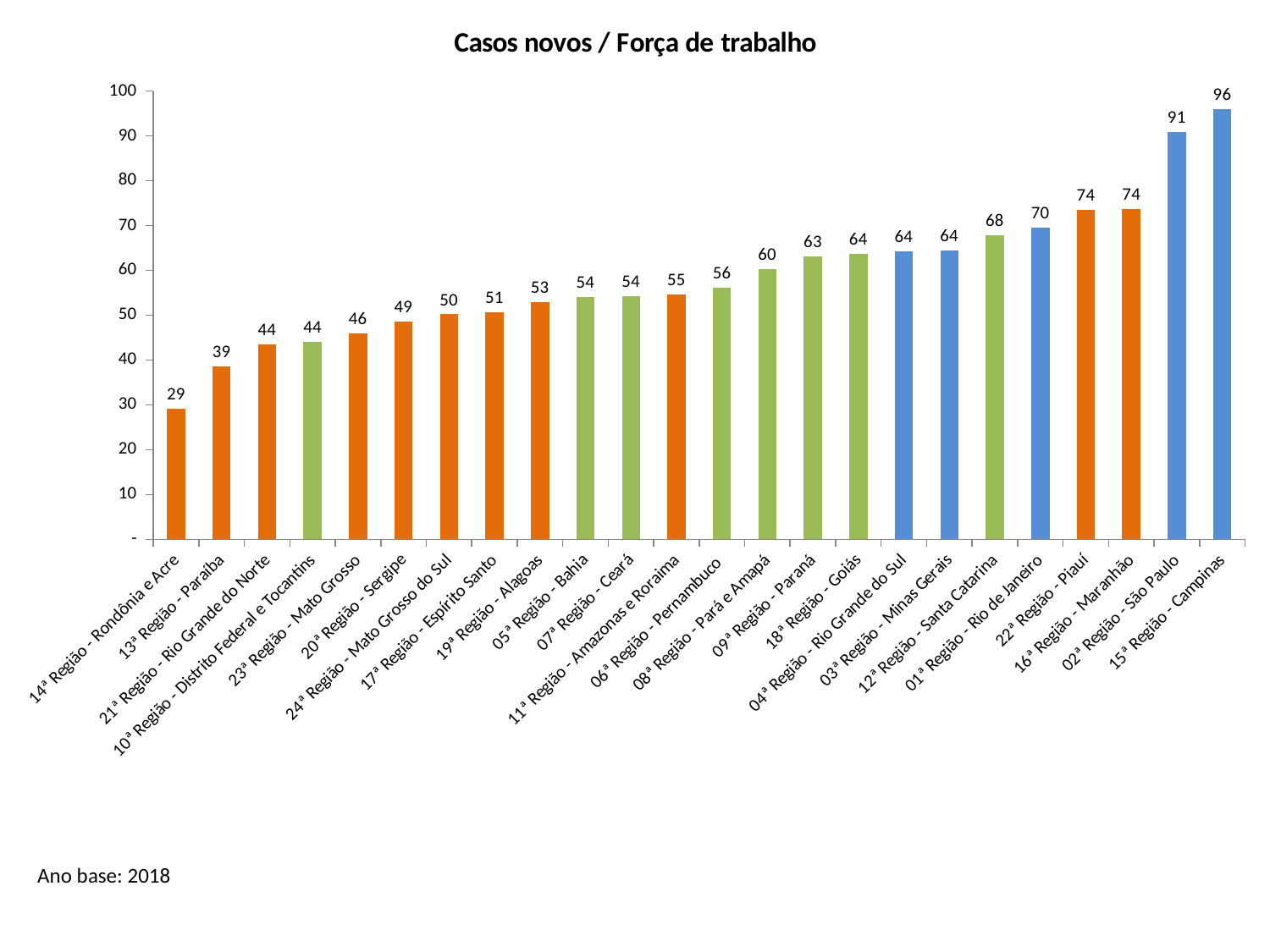
How many bars are plotted in the chart? 24 What is the value for 14ª Região - Rondônia e Acre? 29 What is the difference between the values for 15ª Região - Campinas and 02ª Região - São Paulo? 5 Which category has the highest value? 15ª Região - Campinas What is the title of the chart? Casos novos / Força de trabalho Which category has the lowest value? 14ª Região - Rondônia e Acre Which is larger, the value for 01ª Região - Rio de Janeiro or the value for 09ª Região - Paraná? 01ª Região - Rio de Janeiro What is the value for 02ª Região - São Paulo? 91 What is the value for 06ª Região - Pernambuco? 56 What kind of chart is shown on the slide? Bar chart What is the value for 12ª Região - Santa Catarina? 68 Do the values rise or fall from left to right along the x axis? Rise